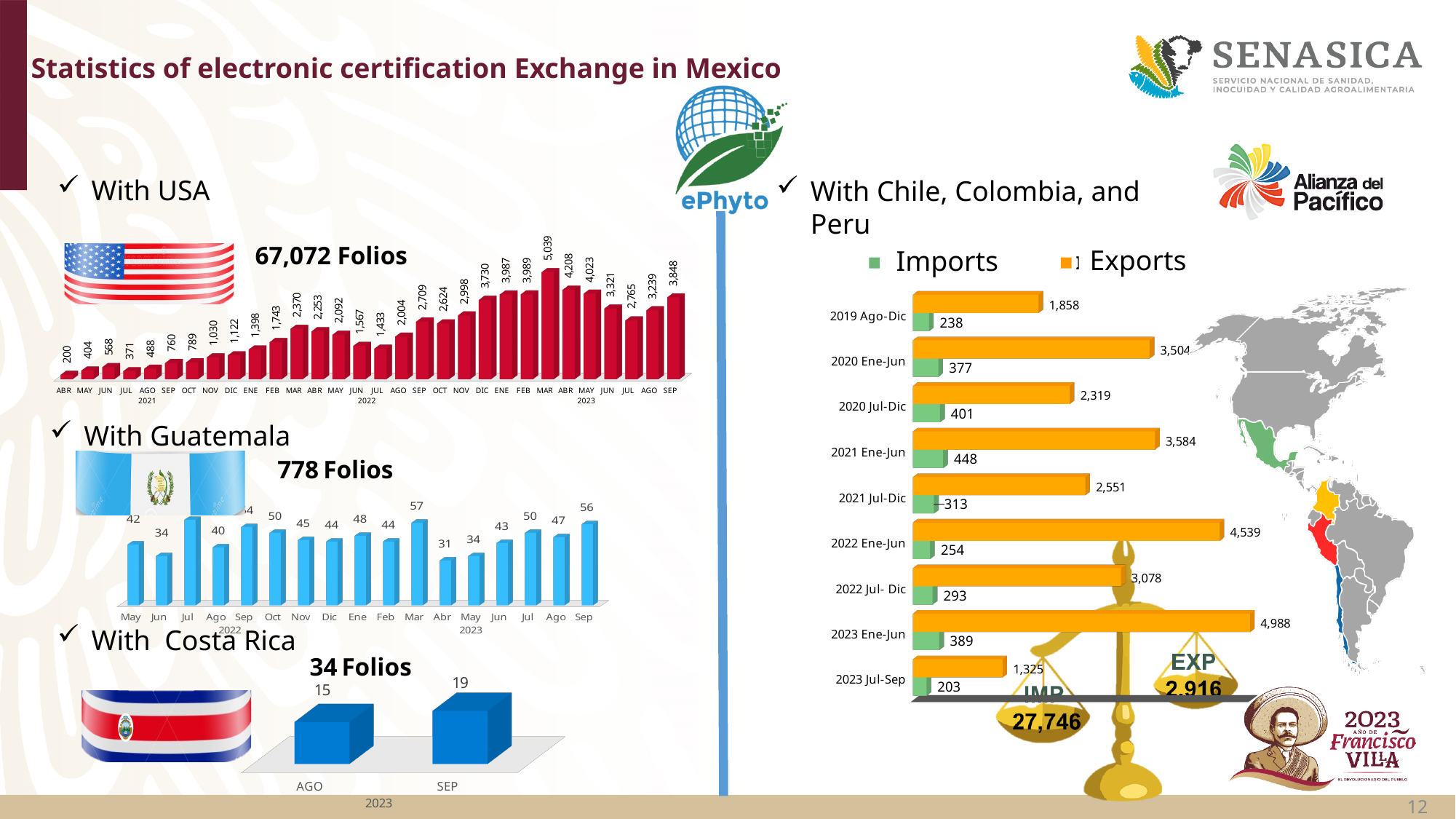
In the 'With USA' chart, what is the difference between SEP 2023 and AGO 2023? 609 In the 'With Chile, Colombia, and Peru' chart, what is the Exports value for 2023 Ene-Jun? 4,988 In the 'With Chile, Colombia, and Peru' chart, which period has the highest Imports value? 2021 Ene-Jun In the 'With Costa Rica' chart, which is larger, AGO or SEP? SEP In the 'With USA' chart, what is the value for MAR 2023? 5,039 What type of chart is the 'With Costa Rica' chart? Bar chart In the 'With USA' chart, which month has the lowest value? ABR 2021 How many bars are plotted in the 'With USA' chart? 30 In the 'With Chile, Colombia, and Peru' chart, what is the difference between Exports and Imports for 2019 Ago-Dic? 1,620 In the 'With Guatemala' chart, what is the value for Abr 2023? 31 How many series does the legend of the 'With Chile, Colombia, and Peru' chart list? 2